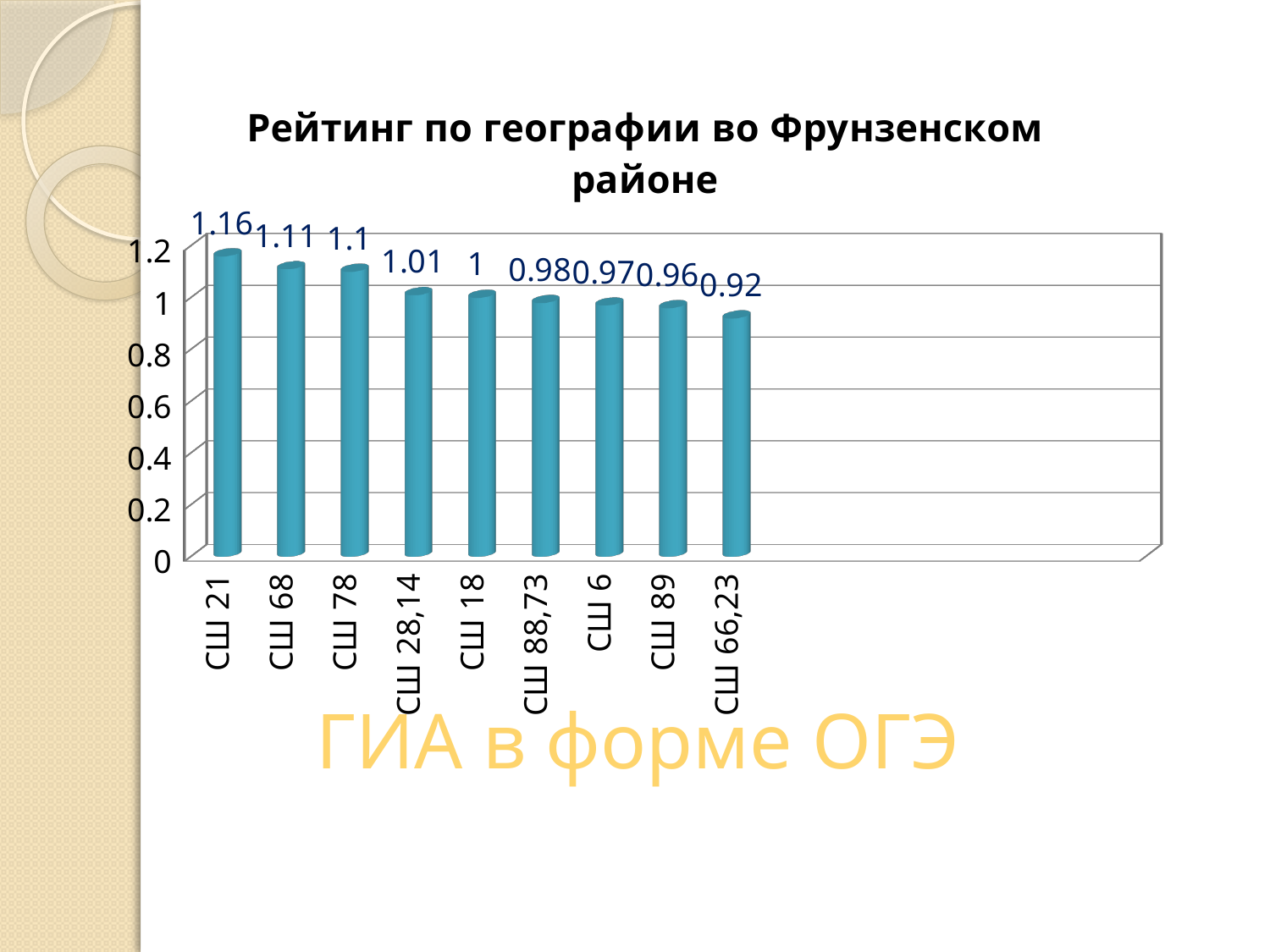
What is the value for СШ 66,23? 0.92 What is the value for СШ 21? 1.16 What is the value for СШ 28,14? 1.01 Which school has the highest value? СШ 21 How many schools are shown on the chart? 9 What is the difference between the values for СШ 21 and СШ 66,23? 0.24 What is the value for СШ 88,73? 0.98 Do the values rise or fall from left to right along the x axis? fall Which has a larger value, СШ 68 or СШ 18? СШ 68 Is the value for СШ 78 greater or less than 1? greater What kind of chart is this? bar chart Which school has the lowest value? СШ 66,23